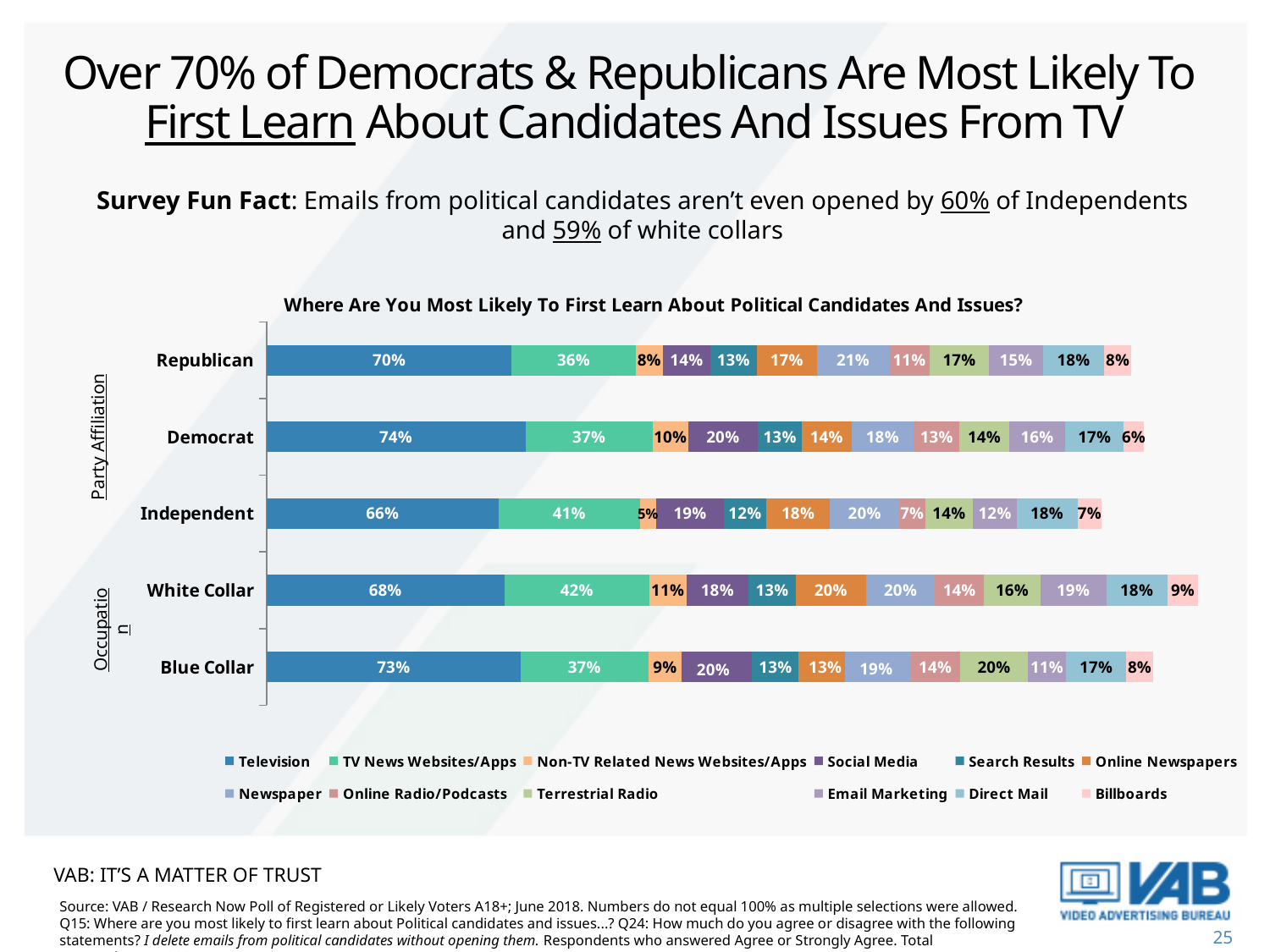
What percentage of Democrats are most likely to first learn about political candidates and issues from Television? 74% How many series does the legend list? 12 What is the Social Media value for Independent? 19% Which category has the lowest Television value? Independent Which has a larger TV News Websites/Apps value, White Collar or Republican? White Collar How many categories are shown on the y axis of the chart? 5 What is the Billboards value for White Collar? 9% What is the difference between the Television values for Democrat and Independent? 8% What kind of chart is shown on the slide? Stacked bar chart Which category has the highest Television value? Democrat What is the Newspaper value for Republican? 21% What is the title of the chart? Where Are You Most Likely To First Learn About Political Candidates And Issues?